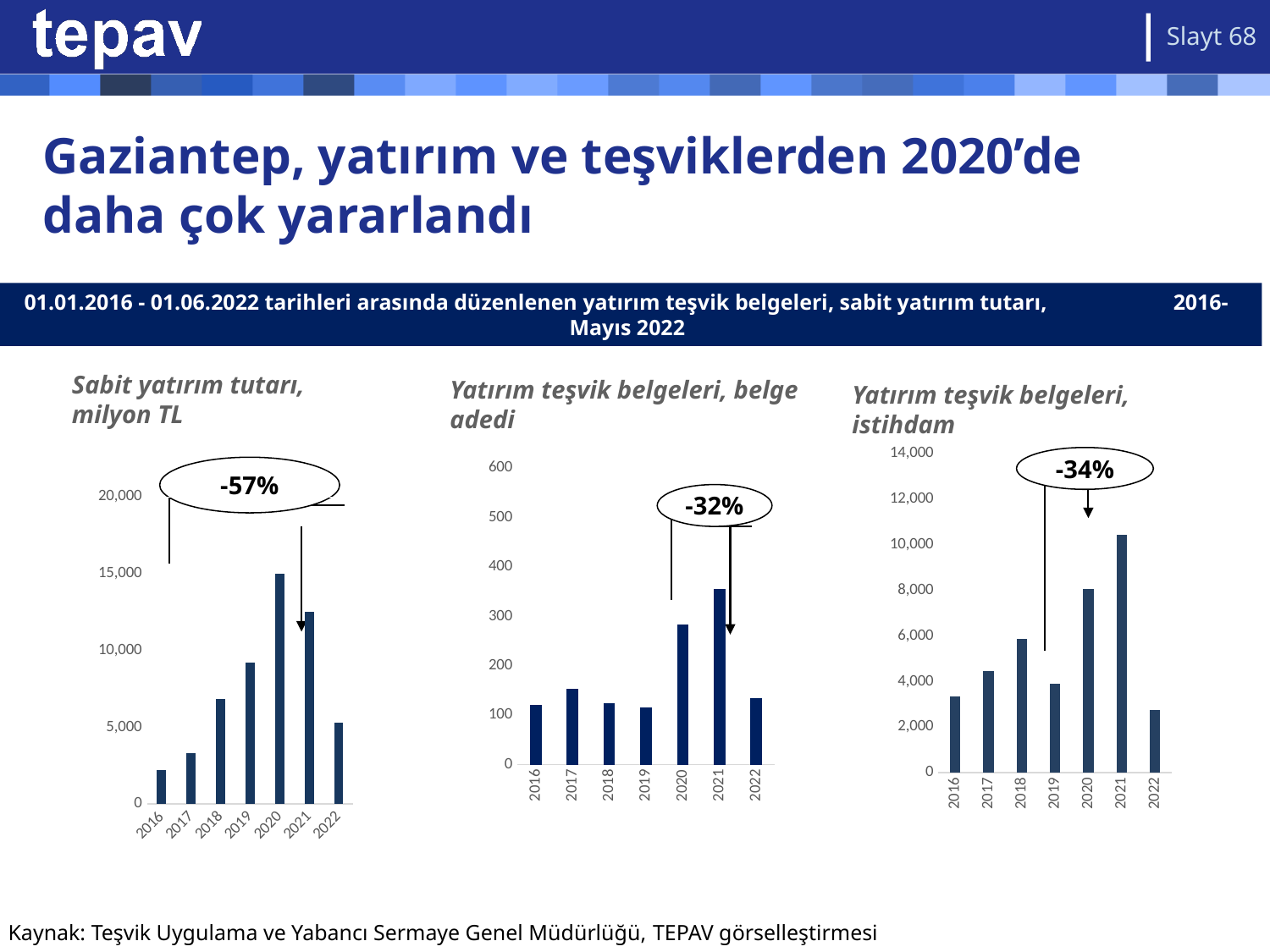
In the 'Yatırım teşvik belgeleri, istihdam' chart, is the value for 2020 greater or less than 6,000? greater In the 'Sabit yatırım tutarı, milyon TL' chart, which year has the lowest bar? 2016 How many years are shown on the x axis of the 'Yatırım teşvik belgeleri, belge adedi' chart? 7 In the 'Sabit yatırım tutarı, milyon TL' chart, is the value for 2021 greater or less than 10,000? greater In the 'Yatırım teşvik belgeleri, belge adedi' chart, is the value for 2020 greater or less than 200? greater In the 'Sabit yatırım tutarı, milyon TL' chart, what percentage change is shown in the annotation? -57% What kind of chart is the 'Yatırım teşvik belgeleri, istihdam' chart? Bar chart In the 'Yatırım teşvik belgeleri, belge adedi' chart, which is larger, the value for 2021 or the value for 2022? 2021 In the 'Yatırım teşvik belgeleri, istihdam' chart, which year has the highest bar? 2021 In the 'Yatırım teşvik belgeleri, istihdam' chart, which year has the lowest bar? 2022 In the 'Yatırım teşvik belgeleri, belge adedi' chart, which year has the highest bar? 2021 In the 'Sabit yatırım tutarı, milyon TL' chart, which year has the highest bar? 2020